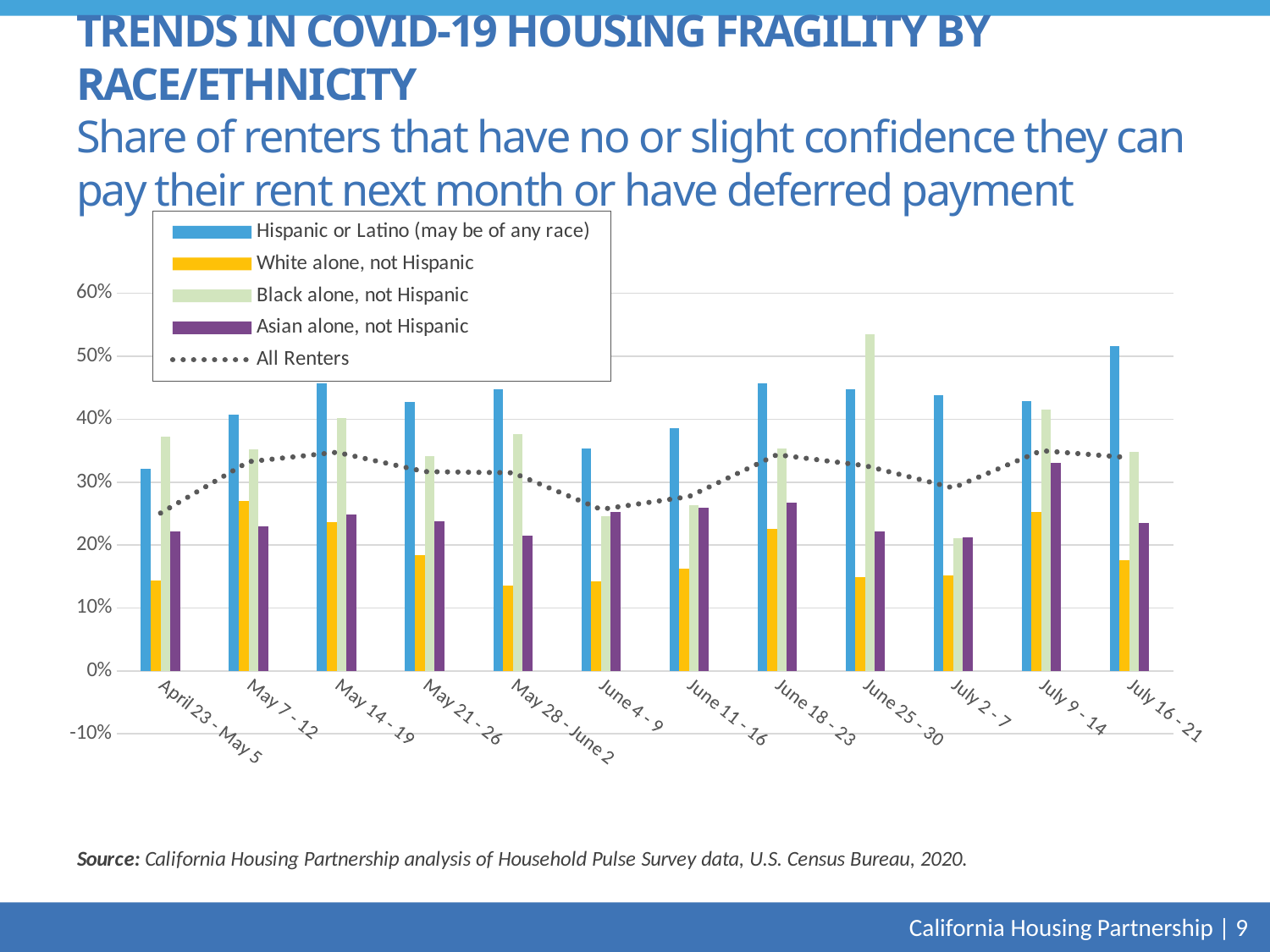
Does the All Renters line rise or fall from June 4 - 9 to June 18 - 23? rise In June 25 - 30, which is larger: the value for Black alone, not Hispanic or the value for Hispanic or Latino (may be of any race)? Black alone, not Hispanic How many survey periods (categories) are shown along the x axis? 12 How many series does the legend list? 5 In April 23 - May 5, which is larger: the value for Hispanic or Latino (may be of any race) or the value for Black alone, not Hispanic? Black alone, not Hispanic Is the value for Black alone, not Hispanic in June 25 - 30 greater or less than 50%? greater What kind of chart is shown on the slide? combination bar and line chart Is the value for White alone, not Hispanic in June 25 - 30 greater or less than 20%? less Which series is shown as a dotted line rather than bars? All Renters Is the value for Asian alone, not Hispanic in July 9 - 14 greater or less than 30%? greater Which survey period has the highest value for Hispanic or Latino (may be of any race)? July 16 - 21 Which survey period has the highest value for White alone, not Hispanic? May 7 - 12